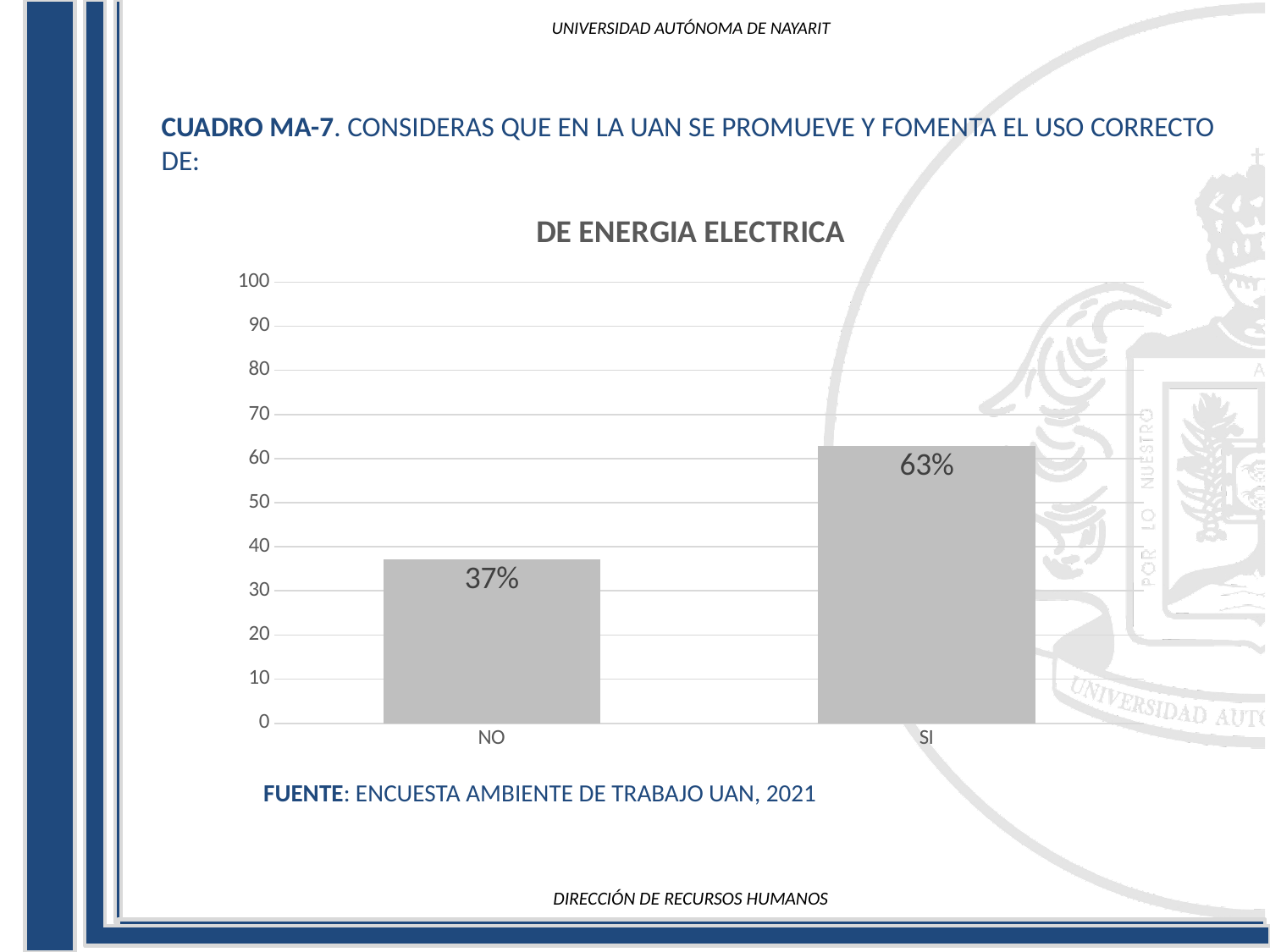
What kind of chart is shown on the slide? bar chart What is the highest value shown on the y axis? 100 How many categories are shown on the x axis? 2 Is the value for SI greater or less than 60? greater Which is larger, the value for NO or the value for SI? SI What is the title of the chart? DE ENERGIA ELECTRICA What is the difference between the values for SI and NO? 26% What is the value for NO? 37% Which category has the highest value? SI Is the value for NO greater or less than 40? less What is the value for SI? 63% Which category has the lowest value? NO